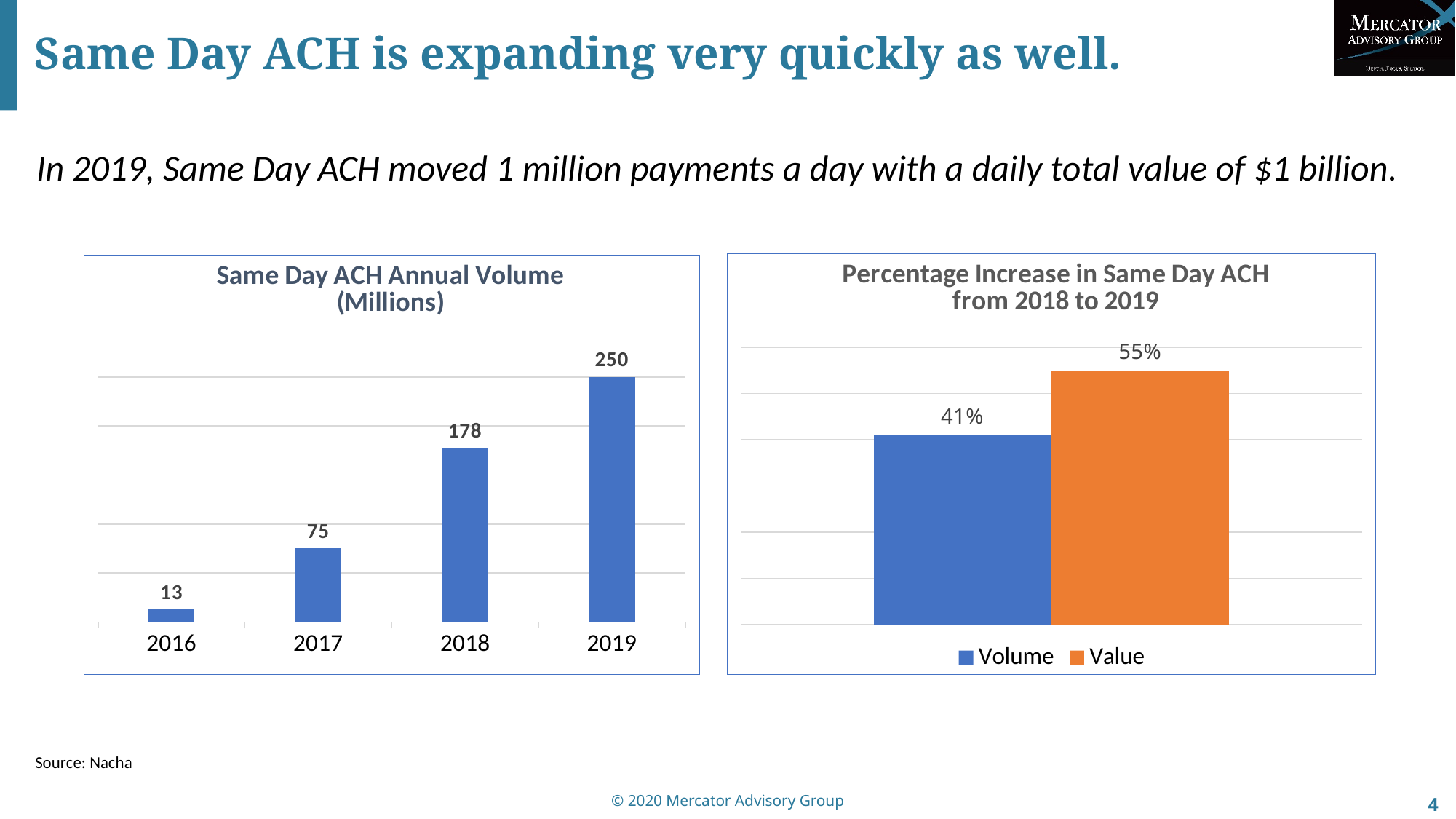
In the 'Percentage Increase in Same Day ACH from 2018 to 2019' chart, which is larger, Volume or Value? Value In the 'Same Day ACH Annual Volume (Millions)' chart, what is the value for 2016? 13 In the 'Same Day ACH Annual Volume (Millions)' chart, which year has the lowest volume? 2016 In the 'Same Day ACH Annual Volume (Millions)' chart, what is the value for 2018? 178 In the 'Same Day ACH Annual Volume (Millions)' chart, which year has the highest volume? 2019 In the 'Same Day ACH Annual Volume (Millions)' chart, how many years are shown? 4 How many series does the legend of the 'Percentage Increase in Same Day ACH from 2018 to 2019' chart list? 2 In the 'Percentage Increase in Same Day ACH from 2018 to 2019' chart, what is the value for Volume? 41% In the 'Same Day ACH Annual Volume (Millions)' chart, what is the difference between the 2019 and 2018 values? 72 What kind of chart is the 'Same Day ACH Annual Volume (Millions)' chart? bar chart In the 'Percentage Increase in Same Day ACH from 2018 to 2019' chart, what is the value for Value? 55% In the 'Same Day ACH Annual Volume (Millions)' chart, do the values rise or fall from 2016 to 2019? rise